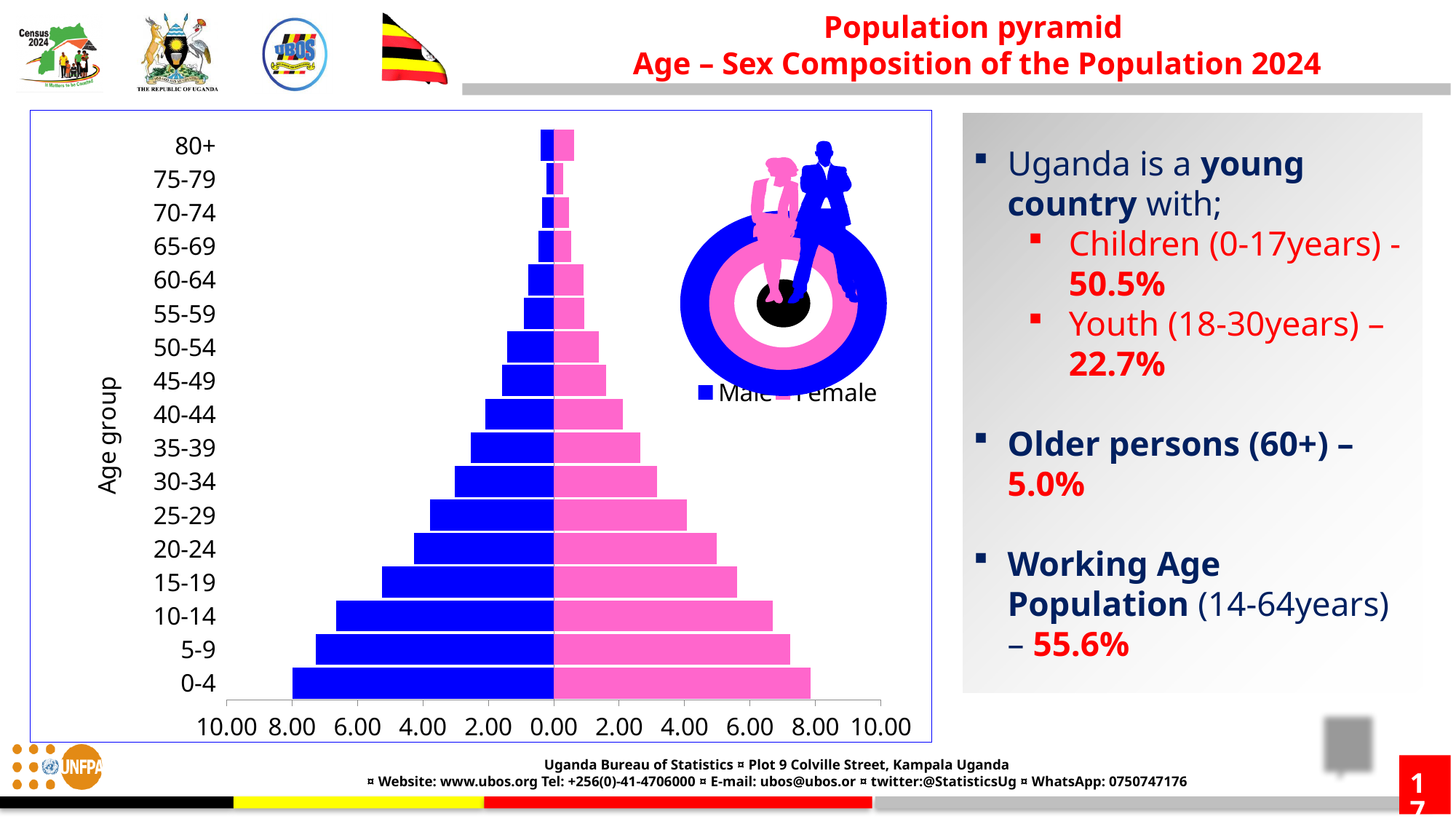
What kind of chart is shown on the slide? Bar chart (population pyramid) As the age group increases from 0-4 to 80+, do the bar lengths generally rise or fall? fall Which colour represents Female in the chart's legend? Pink Which is larger, the Male bar for 5-9 or the Male bar for 10-14? 5-9 Which age group has the longest bars for both Male and Female? 0-4 Is the Male value for the 15-19 age group greater or less than 6.00? less Is the Female value for the 10-14 age group greater or less than 6.00? greater Which age group has the shortest Male bar? 75-79 Is the Male value for the 5-9 age group greater or less than 6.00? greater How many series does the chart's legend list? 2 How many age groups are plotted on the chart? 17